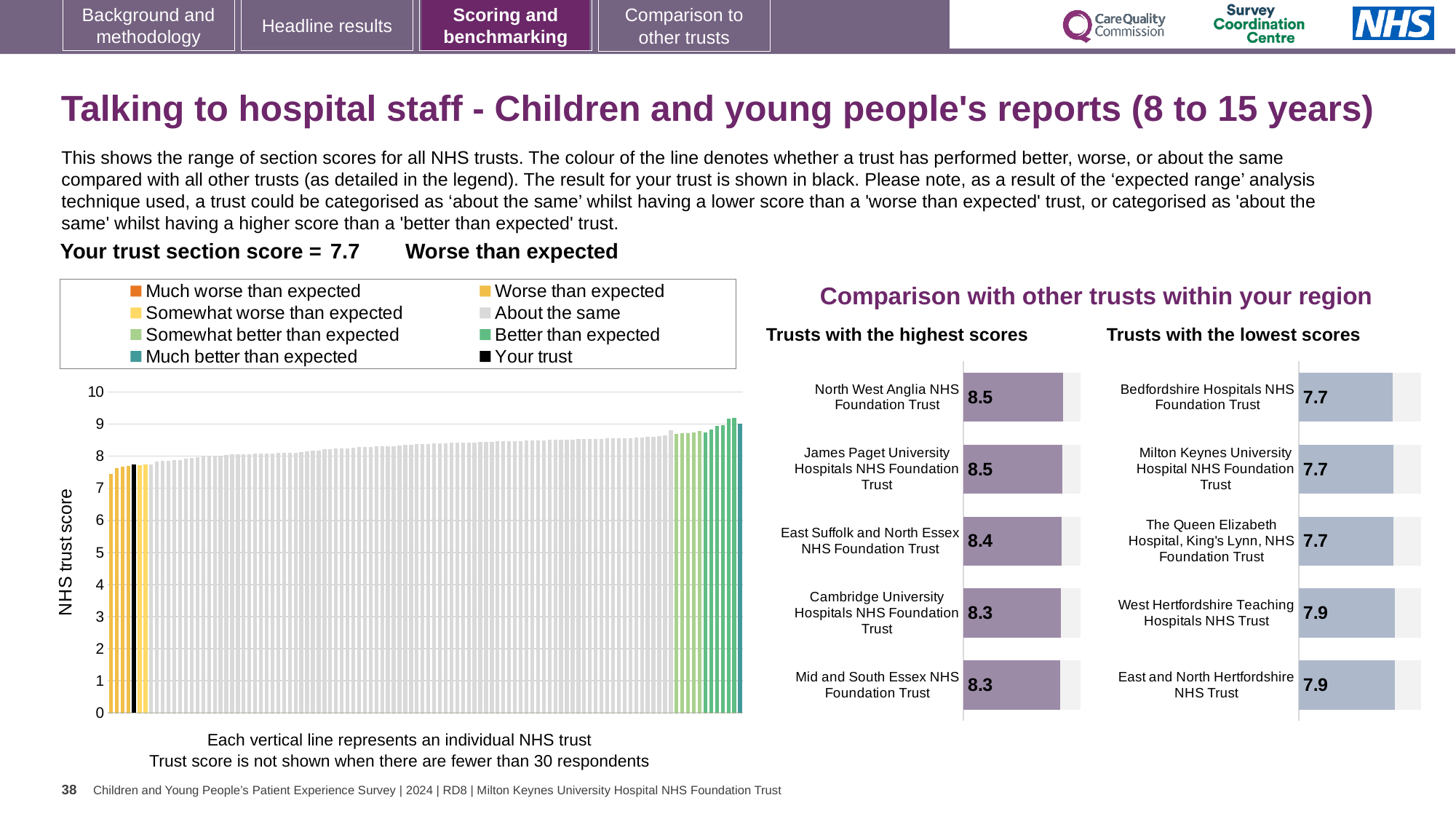
In the large chart on the left, do the trust scores rise or fall from left to right? Rise In the large chart on the left, what is the label on the vertical axis? NHS trust score In the 'Trusts with the highest scores' chart, which has the higher score: East Suffolk and North Essex NHS Foundation Trust or Cambridge University Hospitals NHS Foundation Trust? East Suffolk and North Essex NHS Foundation Trust In the 'Trusts with the lowest scores' chart, how many trusts are listed? 5 What kind of chart is the large chart on the left showing NHS trust scores? Bar chart In the 'Trusts with the lowest scores' chart, what is the score for West Hertfordshire Teaching Hospitals NHS Trust? 7.9 In the 'Trusts with the highest scores' chart, what is the score for East Suffolk and North Essex NHS Foundation Trust? 8.4 How many entries does the legend above the large chart on the left list? 8 In the 'Trusts with the highest scores' chart, what is the difference between the scores of North West Anglia NHS Foundation Trust and Mid and South Essex NHS Foundation Trust? 0.2 In the 'Trusts with the highest scores' chart, how many trusts are listed? 5 What is the section score for your trust shown on the slide? 7.7 In the 'Trusts with the lowest scores' chart, what is the difference between the scores of East and North Hertfordshire NHS Trust and Bedfordshire Hospitals NHS Foundation Trust? 0.2